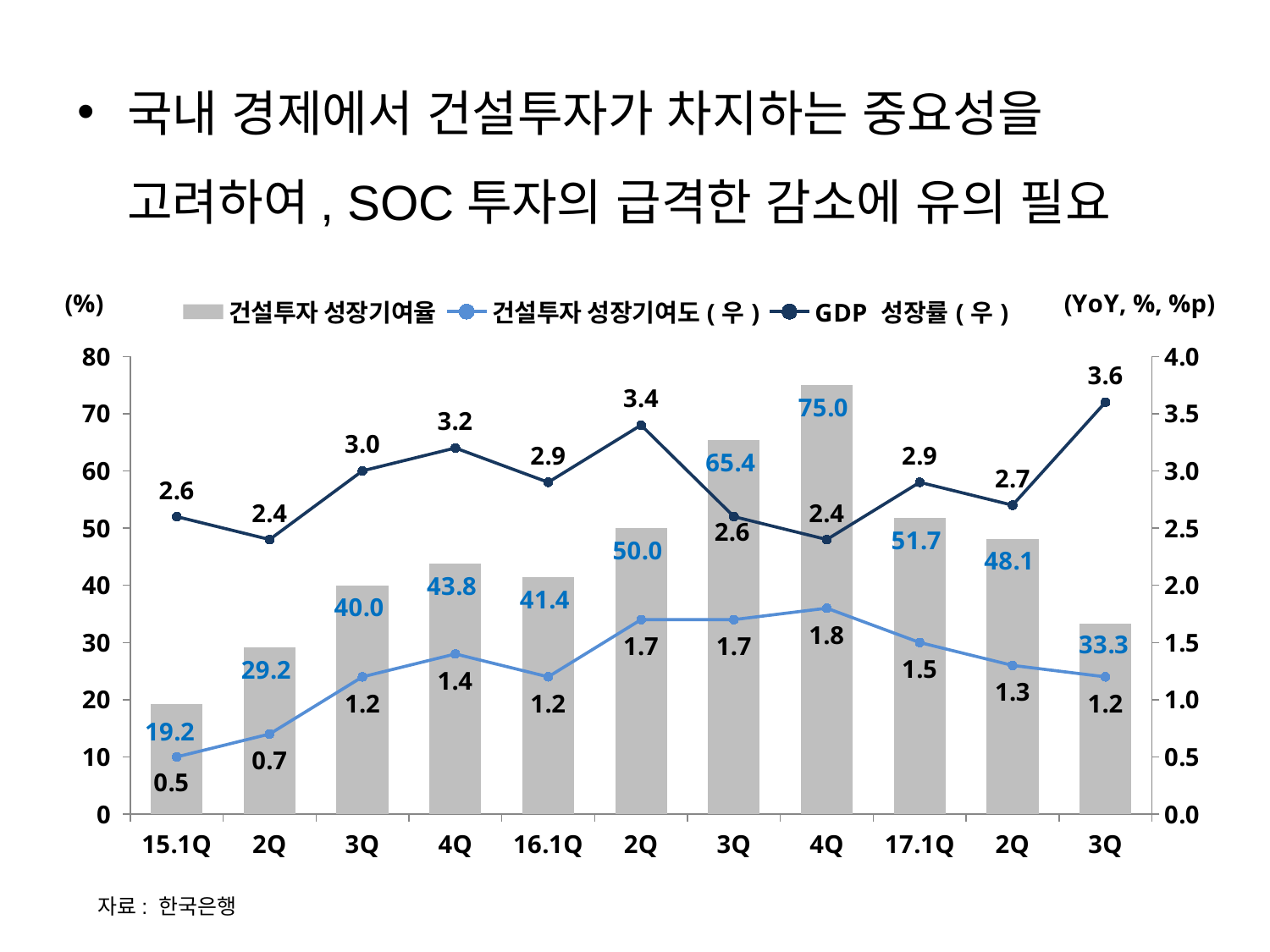
What is the GDP 성장률 (우) value for 17.1Q? 2.9 What is the difference between the 건설투자 성장기여율 values for 17.1Q and 16.1Q? 10.3 In which quarter is GDP 성장률 (우) highest? 3Q of 2017 (the rightmost 3Q), 3.6 Which is larger, the GDP 성장률 (우) value for 15.1Q or for 16.1Q? 16.1Q Which quarter has the highest 건설투자 성장기여율 bar? 4Q of 2016 (the 4Q after 16.1Q), 75.0 What is the value of the 건설투자 성장기여율 bar for 16.1Q? 41.4 How many series does the legend list? 3 How many quarters are shown on the x axis? 11 What source is cited below the chart? 한국은행 What is the 건설투자 성장기여도 (우) value for 15.1Q? 0.5 Which quarter has the lowest 건설투자 성장기여율 bar? 15.1Q What kind of chart is shown on the slide? Combination bar and line chart